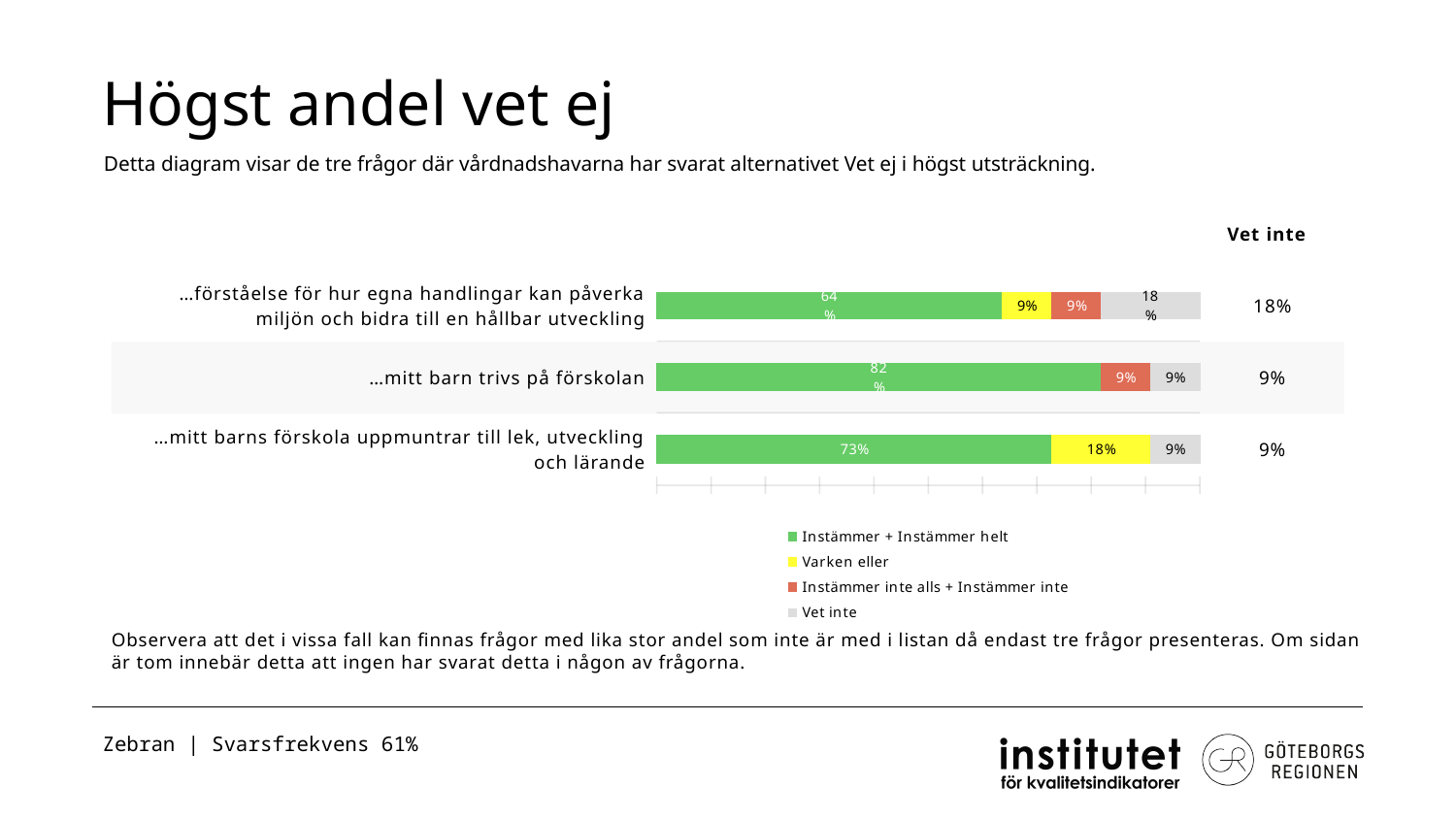
Which category has the lowest "Instämmer + Instämmer helt" value? …förståelse för hur egna handlingar kan påverka miljön och bidra till en hållbar utveckling What kind of chart is shown on the slide? bar chart What is the "Varken eller" value for "…mitt barns förskola uppmuntrar till lek, utveckling och lärande"? 18% What is the "Vet inte" value for "…förståelse för hur egna handlingar kan påverka miljön och bidra till en hållbar utveckling"? 18% Which is larger: the "Vet inte" value for "…förståelse för hur egna handlingar kan påverka miljön och bidra till en hållbar utveckling" or for "…mitt barn trivs på förskolan"? …förståelse för hur egna handlingar kan påverka miljön och bidra till en hållbar utveckling Which category has the highest "Instämmer + Instämmer helt" value? …mitt barn trivs på förskolan What is the difference between the "Instämmer + Instämmer helt" values for "…mitt barn trivs på förskolan" and "…förståelse för hur egna handlingar kan påverka miljön och bidra till en hållbar utveckling"? 18% What is the value of "Instämmer + Instämmer helt" for "…mitt barn trivs på förskolan"? 82% How many categories (questions) are plotted in the chart? 3 Which legend entry is shown in grey? Vet inte What is the value of "Instämmer + Instämmer helt" for "…mitt barns förskola uppmuntrar till lek, utveckling och lärande"? 73% How many series does the legend list? 4